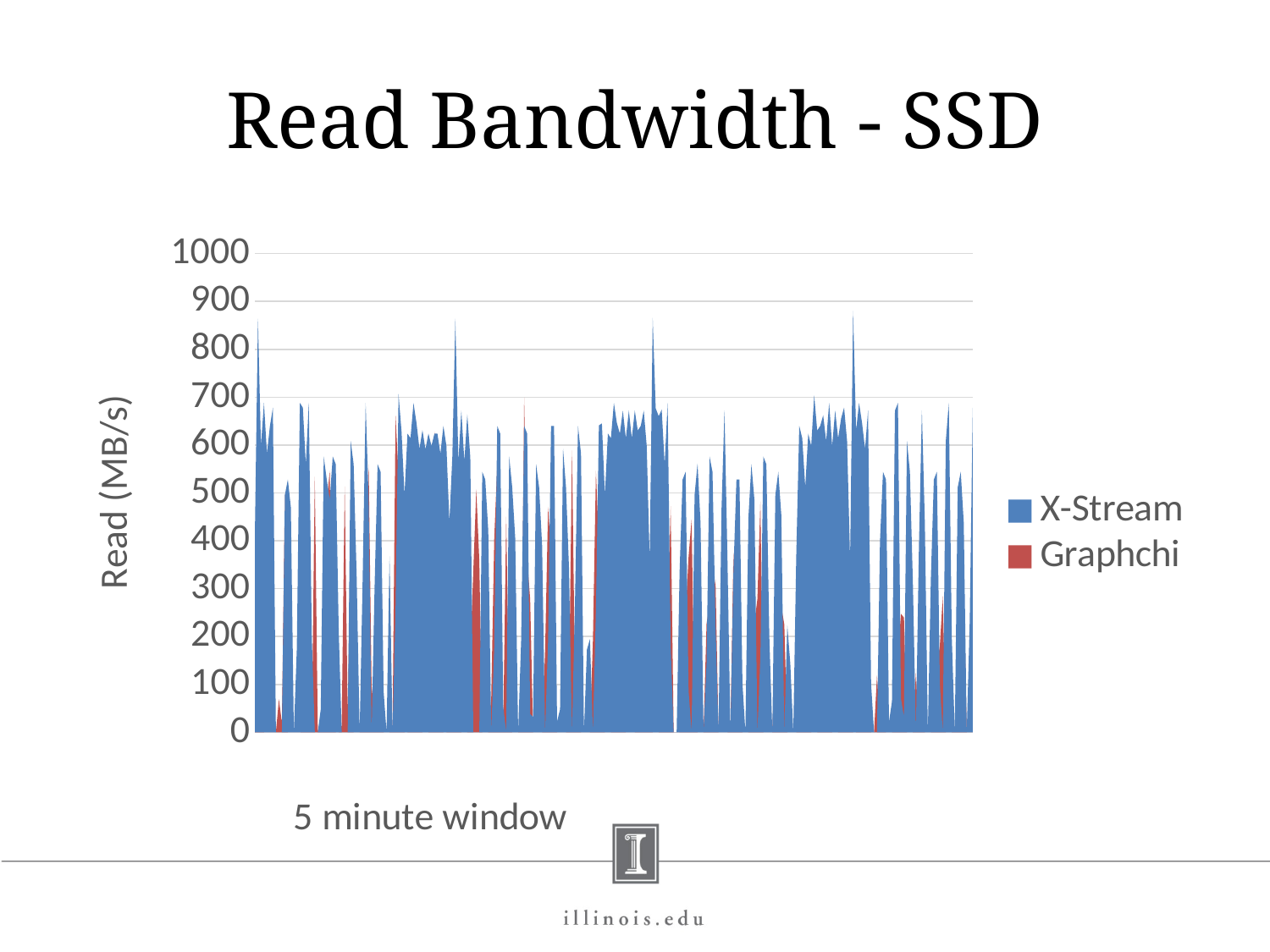
What is the highest value shown on the vertical axis? 1000 Does the X-Stream series ever reach 1000 MB/s? No What kind of chart is shown on the slide? area chart Which series is drawn in blue? X-Stream Which series reaches higher read bandwidth values, X-Stream or Graphchi? X-Stream Is the highest peak of the X-Stream series greater or less than 800? greater How many series does the legend list? 2 What are the two series named in the legend? X-Stream and Graphchi What is the title of the chart's vertical axis? Read (MB/s)